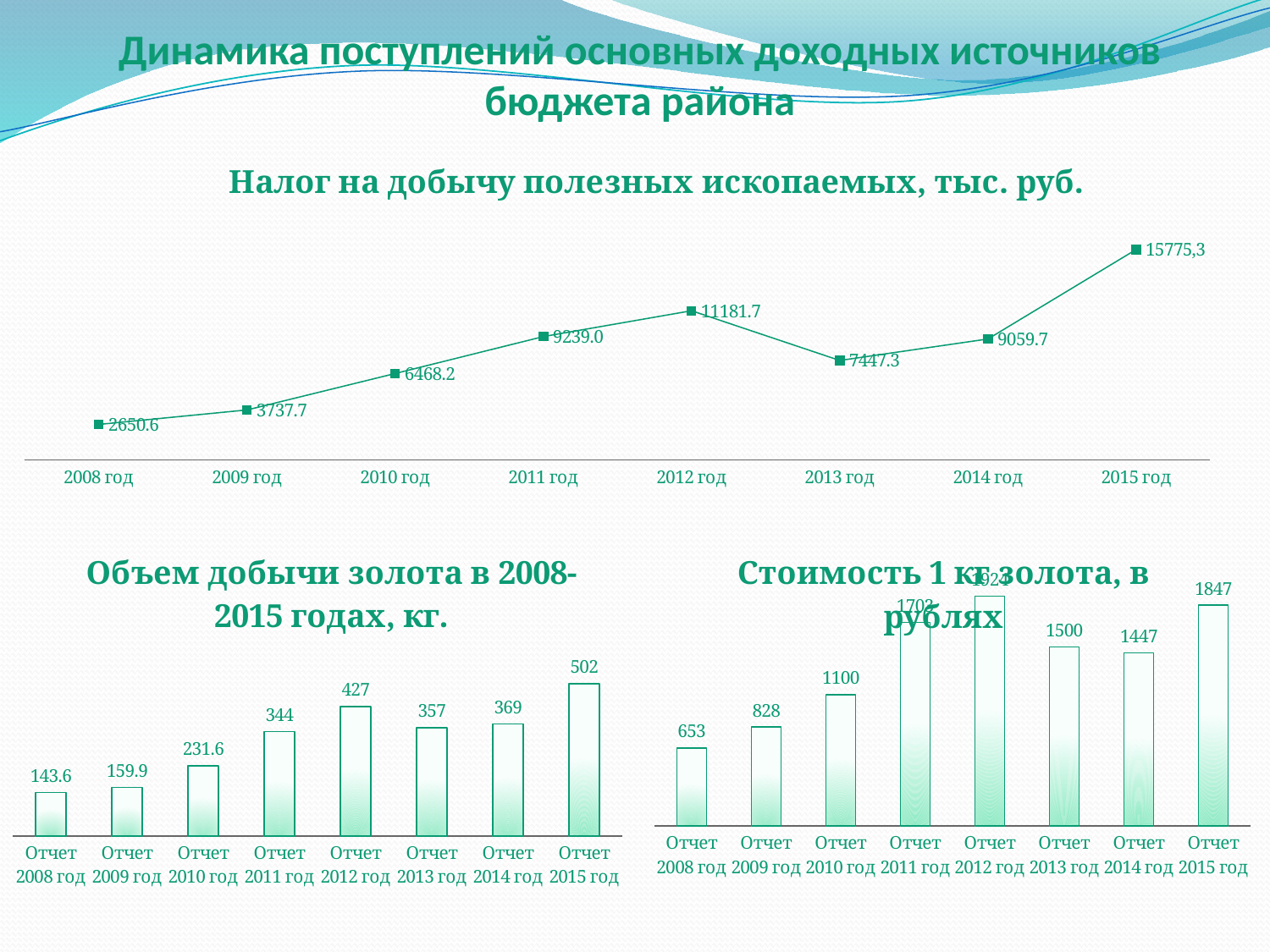
In the chart 'Объем добычи золота в 2008-2015 годах, кг.', which year has the highest value? Отчет 2015 год In the chart 'Налог на добычу полезных ископаемых, тыс. руб.', which year has the highest value? 2015 год In the chart 'Налог на добычу полезных ископаемых, тыс. руб.', what is the value for 2012 год? 11181.7 In the chart 'Налог на добычу полезных ископаемых, тыс. руб.', which year has the lowest value? 2008 год In the chart 'Объем добычи золота в 2008-2015 годах, кг.', what is the difference between the values for Отчет 2012 год and Отчет 2013 год? 70 In the chart 'Налог на добычу полезных ископаемых, тыс. руб.', what is the difference between the values for 2011 год and 2010 год? 2770.8 In the chart 'Объем добычи золота в 2008-2015 годах, кг.', what is the value for Отчет 2010 год? 231.6 In the chart 'Стоимость 1 кг золота, в рублях', what is the value for Отчет 2008 год? 653 How many years are plotted in the chart 'Налог на добычу полезных ископаемых, тыс. руб.'? 8 In the chart 'Стоимость 1 кг золота, в рублях', which is larger: the value for Отчет 2013 год or Отчет 2014 год? Отчет 2013 год What type of chart is 'Налог на добычу полезных ископаемых, тыс. руб.'? line chart In the chart 'Налог на добычу полезных ископаемых, тыс. руб.', which is larger: the value for 2013 год or 2014 год? 2014 год